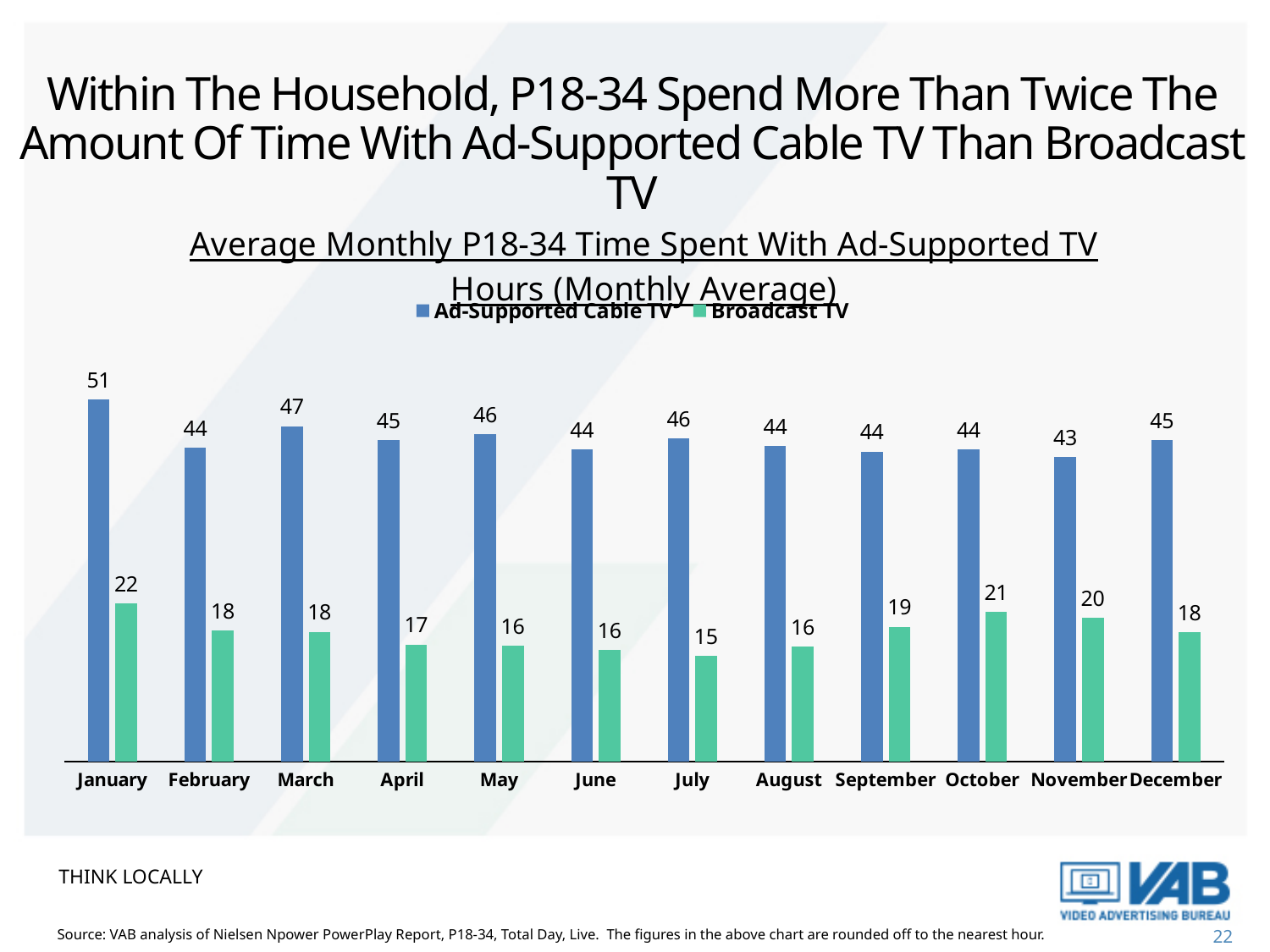
What kind of chart is shown on the slide? Bar chart Which series is shown in green in the legend? Broadcast TV How many series does the legend list? 2 What is the difference between the Ad-Supported Cable TV and Broadcast TV values in January? 29 What is the Broadcast TV value for October? 21 Which is larger, the Broadcast TV value for January or for December? January Which month has the lowest Broadcast TV value? July Which month has the highest Ad-Supported Cable TV value? January What is the difference between the Ad-Supported Cable TV values for January and November? 8 What is the Broadcast TV value for July? 15 What is the Ad-Supported Cable TV value for January? 51 How many months are shown on the x axis? 12